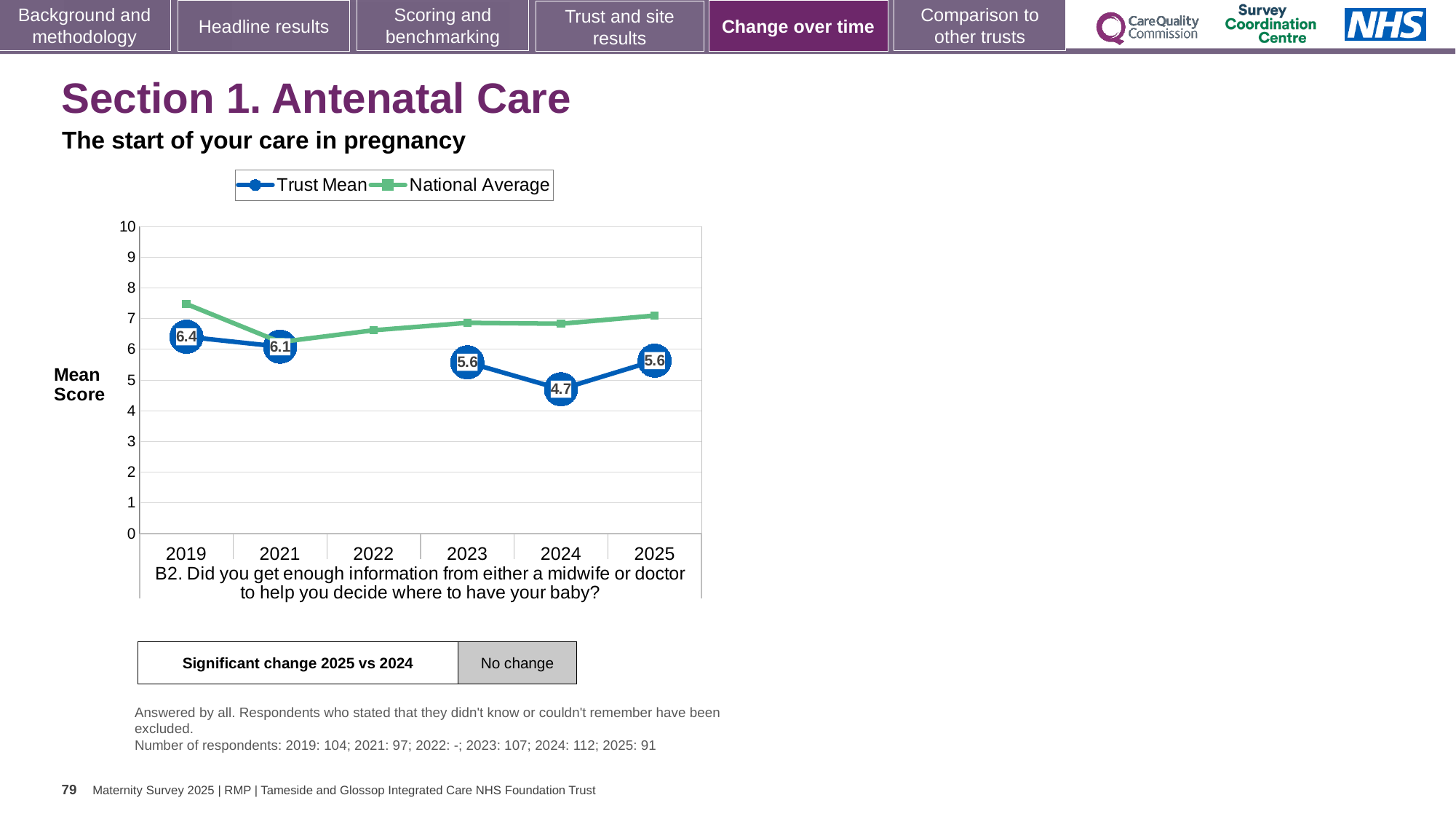
How many years are shown on the x axis? 6 What is the Trust Mean for 2025? 5.6 In which year is the Trust Mean lowest? 2024 What is the Trust Mean for 2019? 6.4 What is the difference between the Trust Mean in 2019 and in 2024? 1.7 Which is larger, the Trust Mean in 2021 or the Trust Mean in 2023? 2021 Is the National Average for 2019 greater or less than 7? greater What is the Trust Mean for 2024? 4.7 Is the National Average for 2024 greater or less than 6? greater What kind of chart is shown? Line chart How many series does the legend list? 2 In which year is the Trust Mean highest? 2019